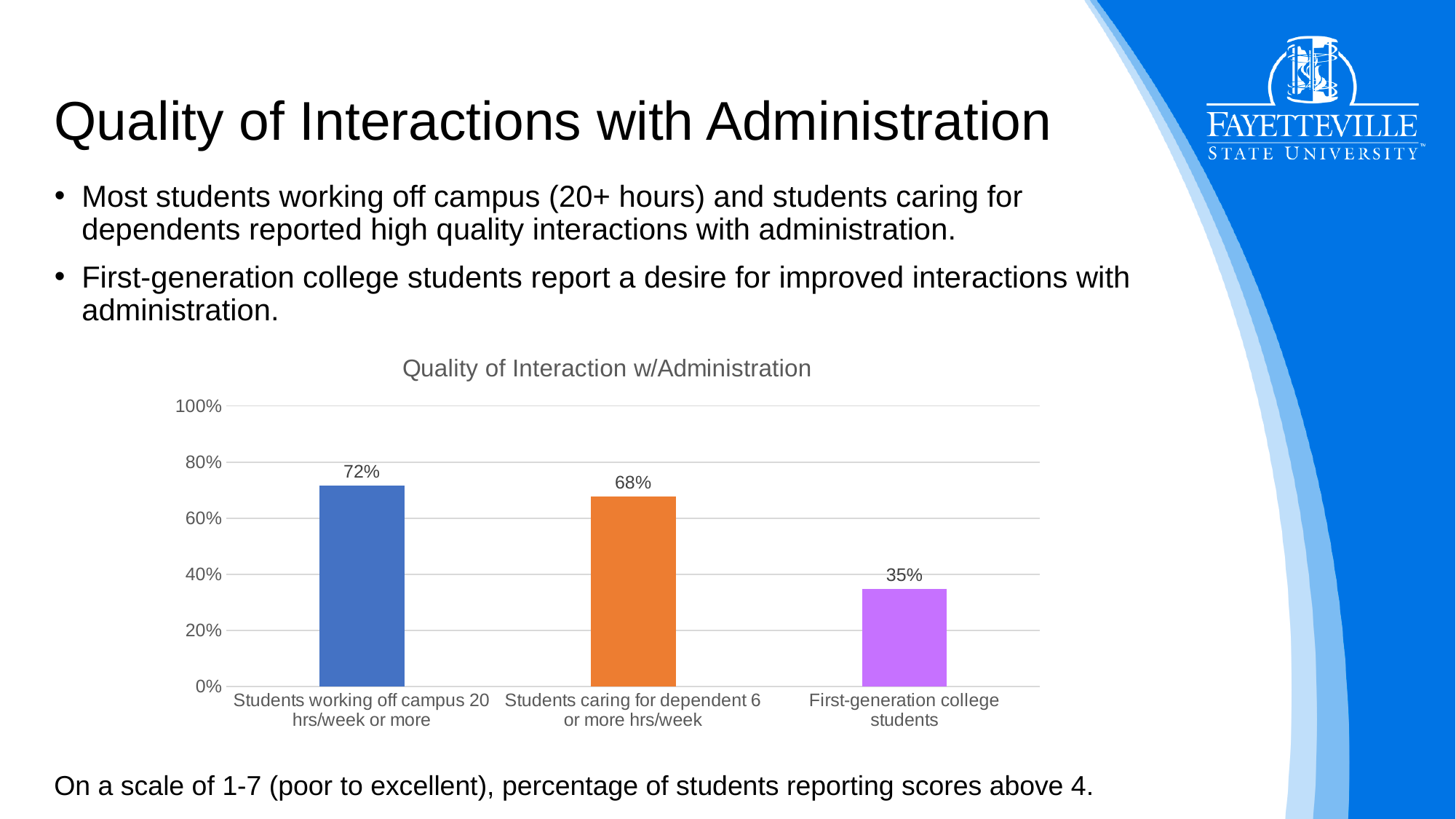
Which category has the highest value? Students working off campus 20 hrs/week or more Which category has the lowest value? First-generation college students What kind of chart is shown on the slide? Bar chart What is the difference between the values for Students caring for dependent 6 or more hrs/week and First-generation college students? 33% Is the value for First-generation college students greater or less than 40%? less What is the difference between the values for Students working off campus 20 hrs/week or more and First-generation college students? 37% How many categories are shown in the chart? 3 What is the value for First-generation college students? 35% Which is larger: the value for Students caring for dependent 6 or more hrs/week or the value for First-generation college students? Students caring for dependent 6 or more hrs/week What is the value for Students working off campus 20 hrs/week or more? 72% What is the title of the chart? Quality of Interaction w/Administration What is the value for Students caring for dependent 6 or more hrs/week? 68%